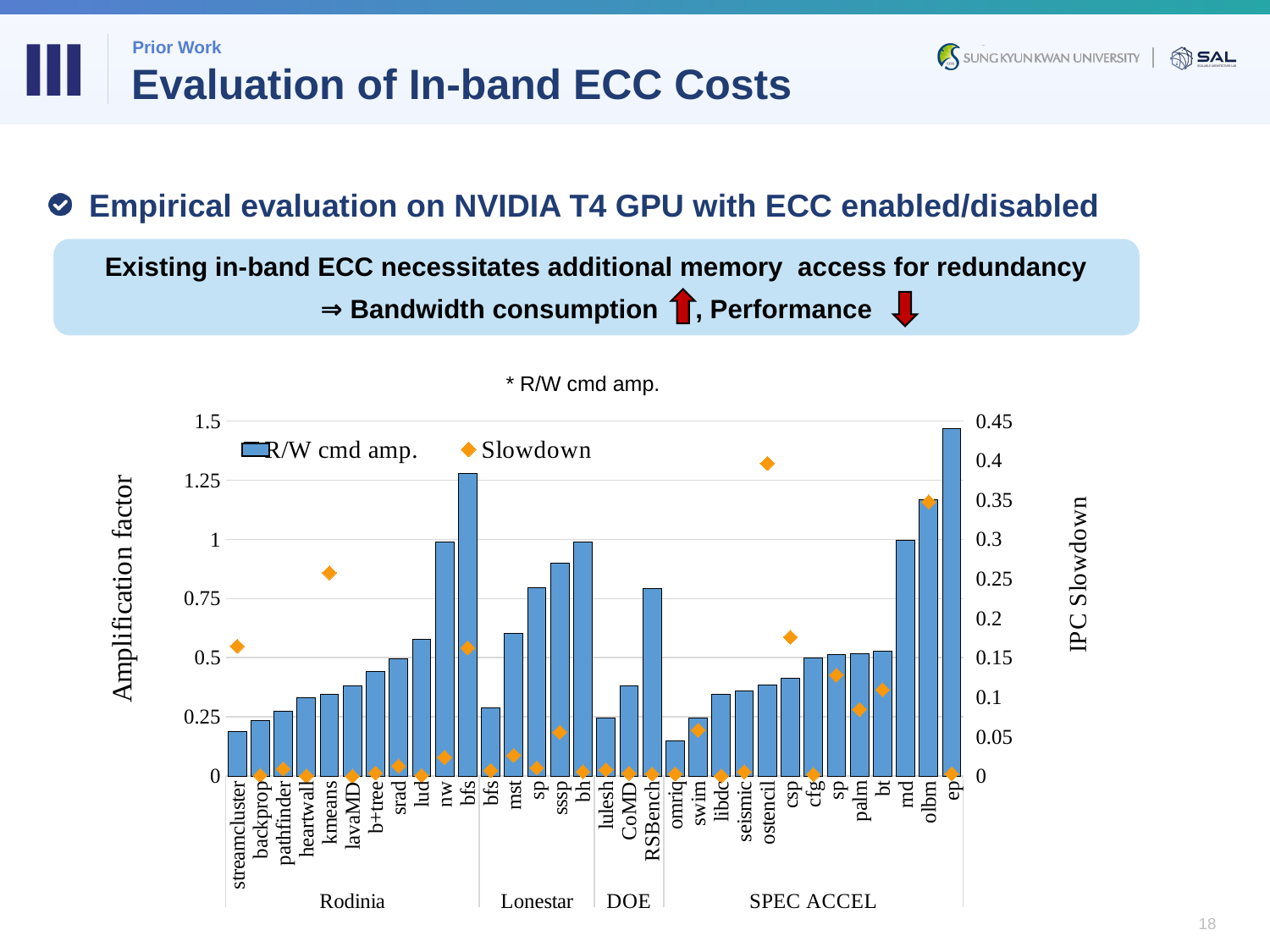
Is the R/W cmd amp. value for omriq greater or less than 0.25? less What is the title of the left vertical axis of the chart? Amplification factor Which benchmark has the lowest R/W cmd amp. bar? omriq Which has the larger R/W cmd amp. bar, ep or streamcluster? ep How many benchmark groups are labelled along the bottom of the chart? 4 Is the Slowdown value for kmeans greater or less than 0.2? greater What are the two series named in the chart legend? R/W cmd amp. and Slowdown How many series does the chart legend list? 2 Which benchmark has the highest R/W cmd amp. bar? ep Which benchmark has the highest Slowdown marker? ostencil What kind of chart is shown on the slide? bar chart Is the R/W cmd amp. value for bfs in the Rodinia group greater or less than 1? greater